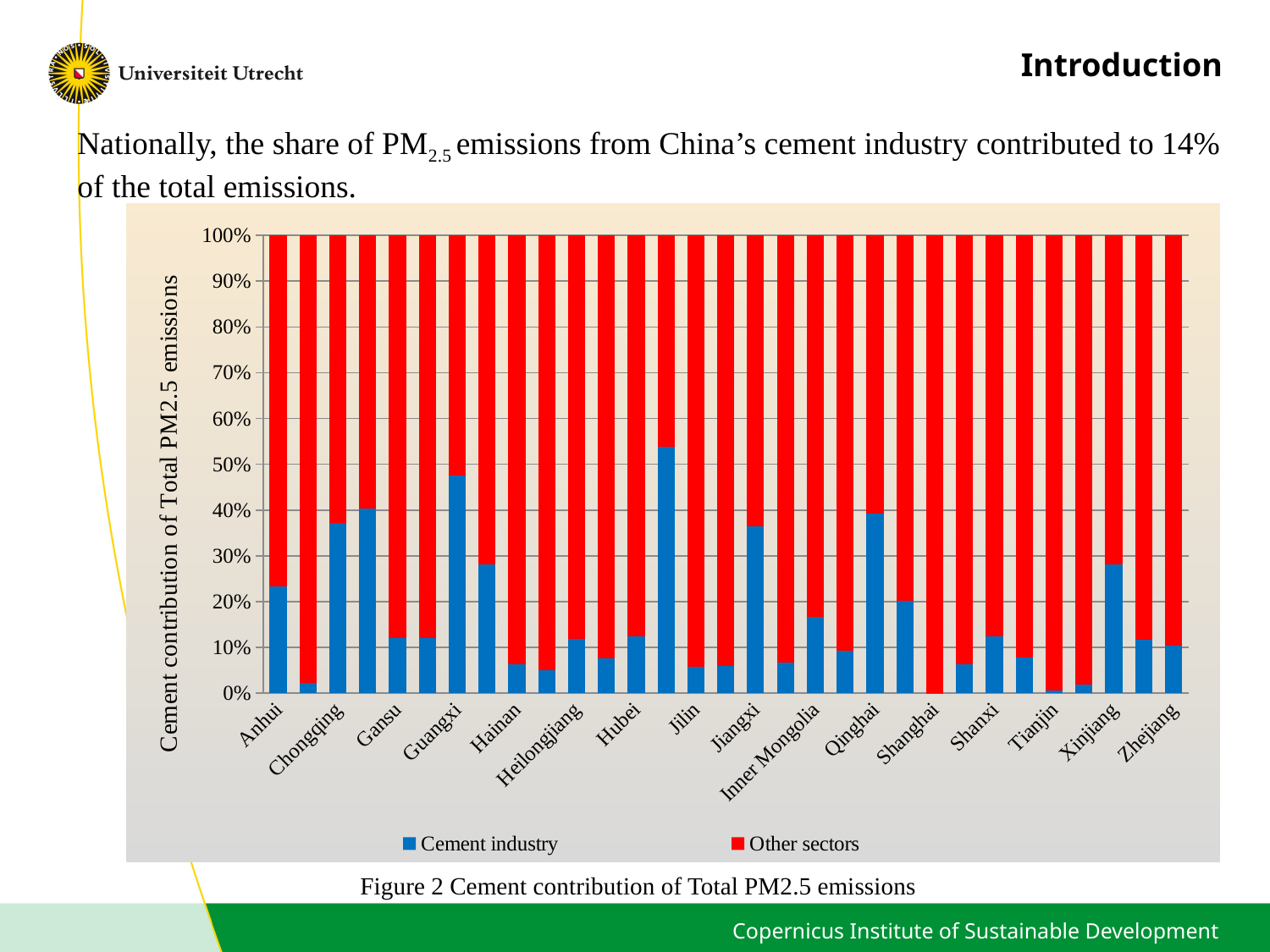
What kind of chart is shown on the slide? Stacked bar chart Is the Cement industry value for Chongqing greater or less than 10%? greater What are the two series named in the chart legend? Cement industry and Other sectors What is the label on the vertical axis of the chart? Cement contribution of Total PM2.5 emissions How many series does the chart legend list? 2 Which has the larger Cement industry share, Qinghai or Tianjin? Qinghai Which has the larger Cement industry share, Guangxi or Anhui? Guangxi Is the Cement industry value for Heilongjiang greater or less than 10%? greater Is the Cement industry value for Anhui greater or less than 20%? greater